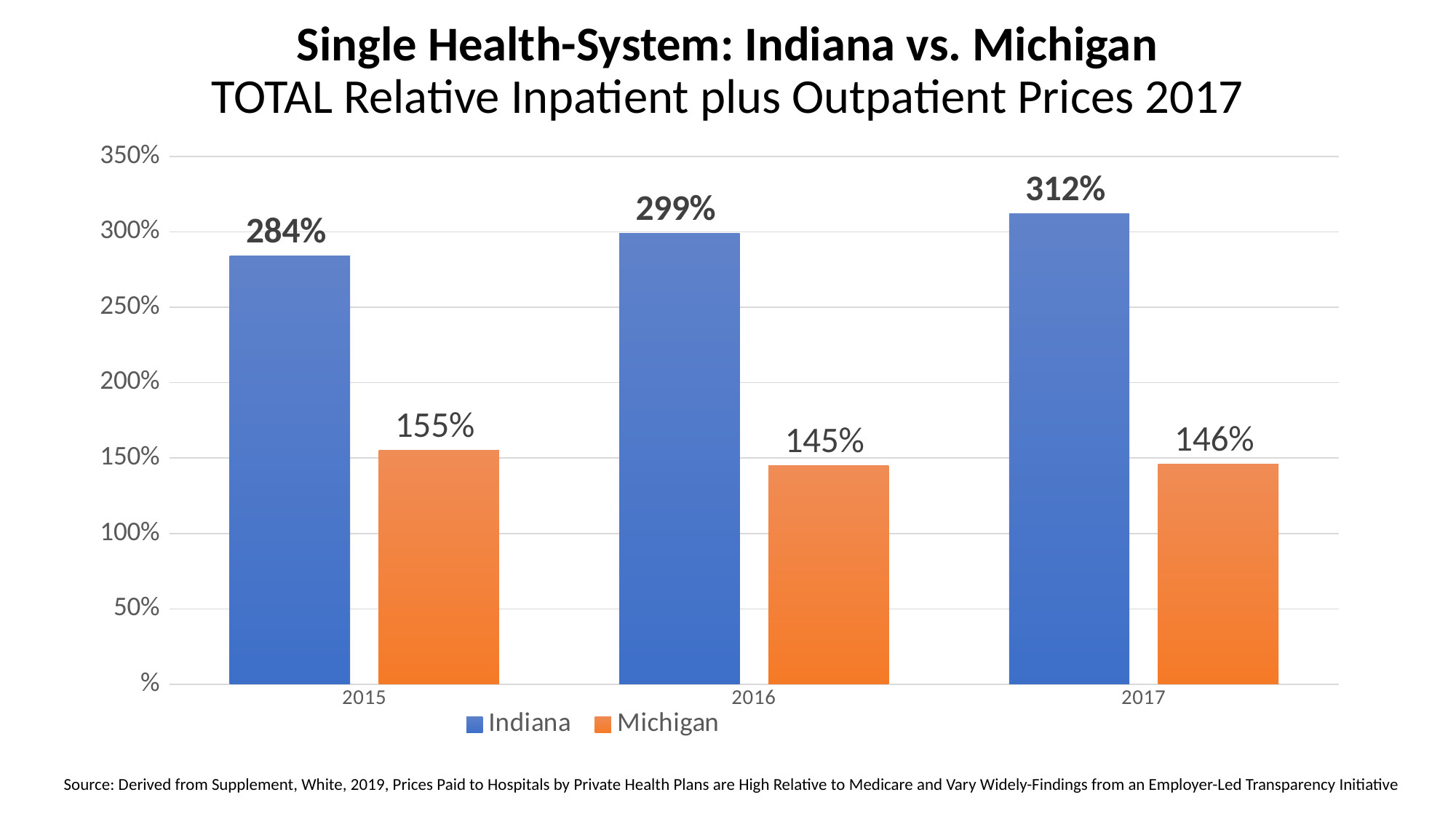
In which year is the Michigan value highest? 2015 What is the value for Michigan in 2016? 145% Do the Indiana values rise or fall from 2015 to 2017? Rise What kind of chart is shown on the slide? Bar chart What is the difference between the Indiana and Michigan values in 2017? 166% What is the difference between the Indiana values in 2016 and 2015? 15% What is the value for Indiana in 2015? 284% Which is larger in 2016, the Indiana value or the Michigan value? Indiana How many years are shown on the x axis? 3 In which year is the Indiana value highest? 2017 How many series does the legend list? 2 What is the value for Indiana in 2017? 312%